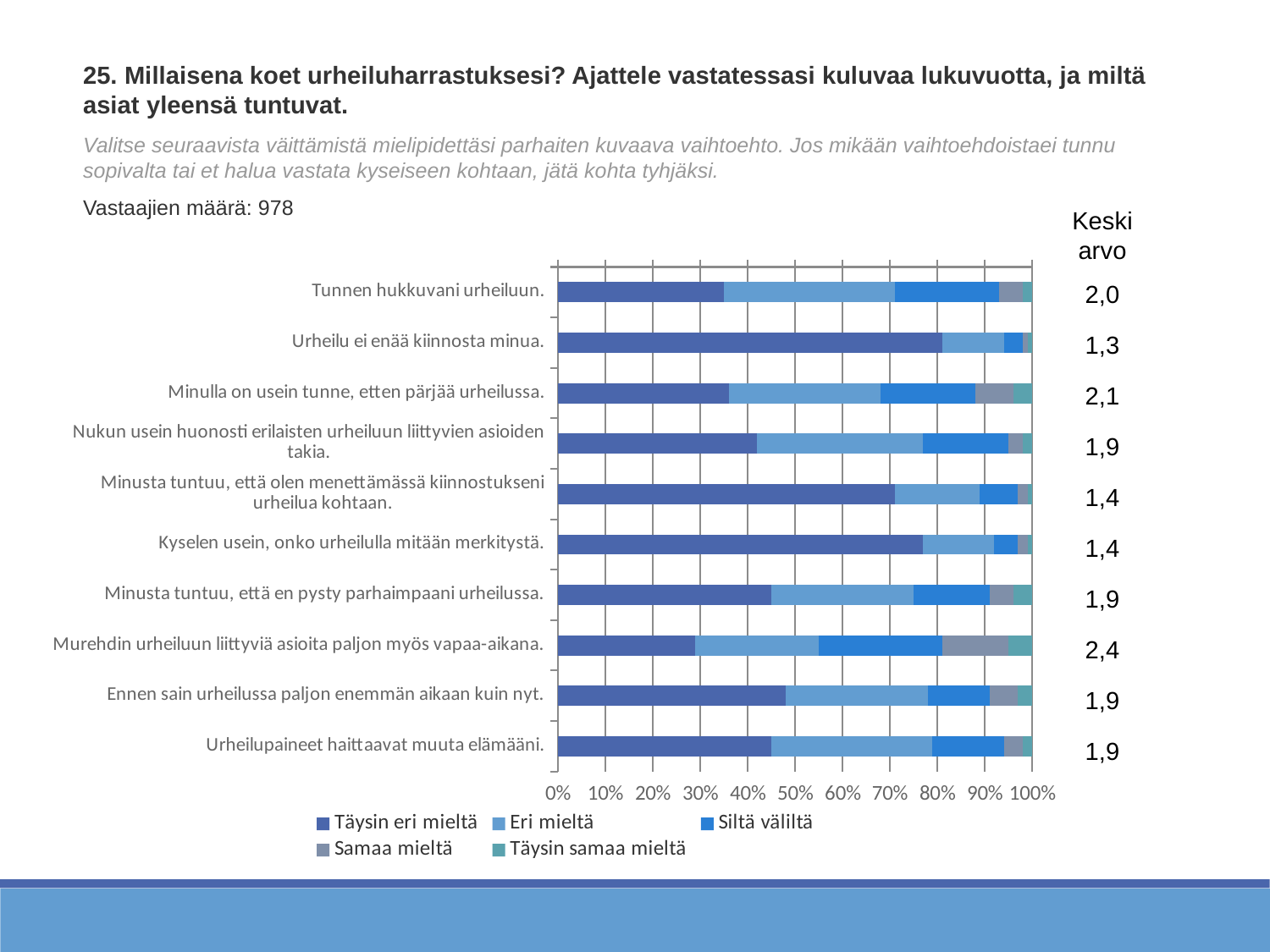
What is the Keskiarvo value shown for "Urheilu ei enää kiinnosta minua."? 1,3 Is the "Täysin eri mieltä" share for "Urheilu ei enää kiinnosta minua." greater or less than 70%? greater Which statement has the lowest Keskiarvo value? Urheilu ei enää kiinnosta minua. What is the Keskiarvo value shown for "Murehdin urheiluun liittyviä asioita paljon myös vapaa-aikana."? 2,4 What is the Keskiarvo (mean) value shown for "Tunnen hukkuvani urheiluun."? 2,0 How many series does the legend list? 5 How many statements (categories) are plotted in the chart? 10 What is the difference between the highest Keskiarvo value (2,4) and the lowest (1,3)? 1,1 Which statement has a larger "Täysin eri mieltä" share: "Urheilu ei enää kiinnosta minua." or "Murehdin urheiluun liittyviä asioita paljon myös vapaa-aikana."? Urheilu ei enää kiinnosta minua. Is the "Täysin eri mieltä" share for "Murehdin urheiluun liittyviä asioita paljon myös vapaa-aikana." greater or less than 40%? less Which statement has the highest Keskiarvo value? Murehdin urheiluun liittyviä asioita paljon myös vapaa-aikana. What kind of chart is shown on the slide? bar chart